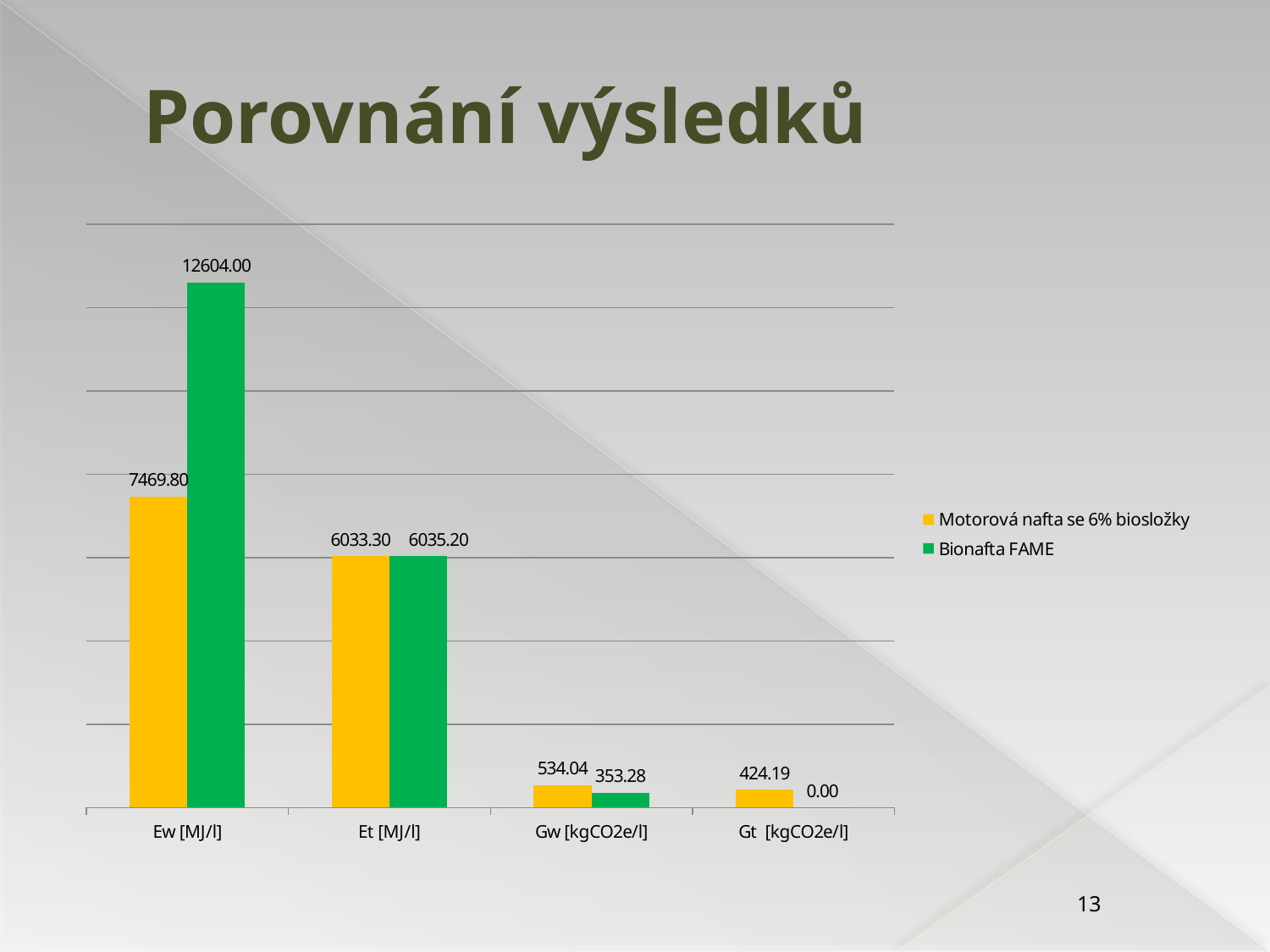
Which category has the lowest value for Motorová nafta se 6% biosložky? Gt [kgCO2e/l] How many categories are shown on the x axis? 4 Which category has the highest value for Bionafta FAME? Ew [MJ/l] What is the difference between the Motorová nafta se 6% biosložky and Bionafta FAME values in the Gw [kgCO2e/l] category? 180.76 What is the value for Motorová nafta se 6% biosložky in the Gw [kgCO2e/l] category? 534.04 What is the difference between the Bionafta FAME and Motorová nafta se 6% biosložky values in the Ew [MJ/l] category? 5134.20 How many series does the legend list? 2 What is the value for Bionafta FAME in the Gt [kgCO2e/l] category? 0.00 What is the value for Bionafta FAME in the Ew [MJ/l] category? 12604.00 What is the value for Motorová nafta se 6% biosložky in the Et [MJ/l] category? 6033.30 In the Gw [kgCO2e/l] category, which series has the larger value? Motorová nafta se 6% biosložky What is the value for Motorová nafta se 6% biosložky in the Ew [MJ/l] category? 7469.80